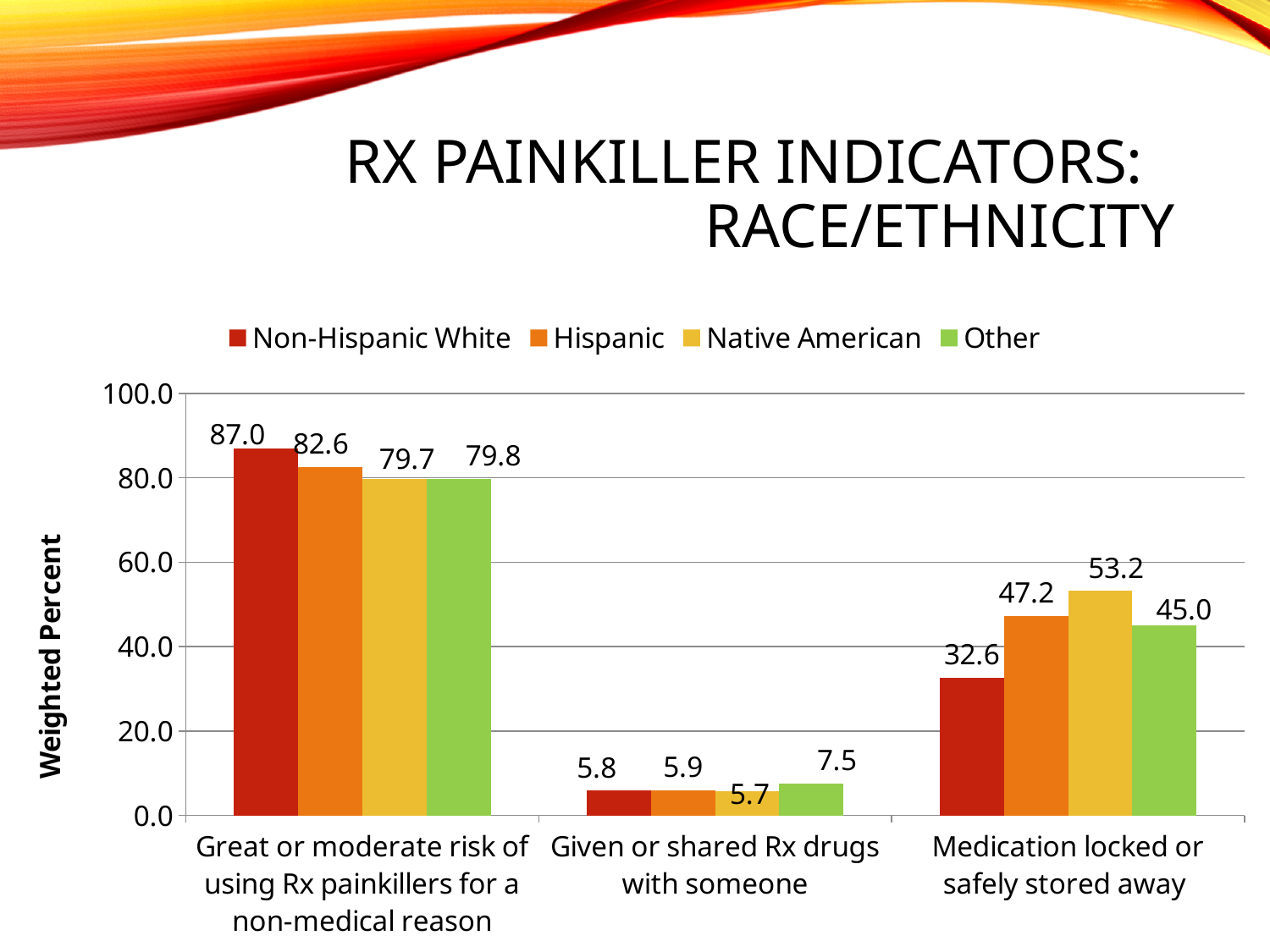
What kind of chart is shown on the slide? Bar chart Is the Native American value for 'Medication locked or safely stored away' greater or less than 60.0? less Which group has the highest value for 'Medication locked or safely stored away'? Native American How many categories are shown on the x axis? 3 Which group has the lowest value for 'Medication locked or safely stored away'? Non-Hispanic White How many series does the legend list? 4 What is the difference between the Non-Hispanic White and Hispanic values for 'Great or moderate risk of using Rx painkillers for a non-medical reason'? 4.4 For 'Medication locked or safely stored away', which is larger: the Hispanic value or the Other value? Hispanic What is the label of the y axis? Weighted Percent What is the value for Non-Hispanic White in the 'Great or moderate risk of using Rx painkillers for a non-medical reason' category? 87.0 What is the value for Other in the 'Given or shared Rx drugs with someone' category? 7.5 What is the value for Native American in the 'Medication locked or safely stored away' category? 53.2